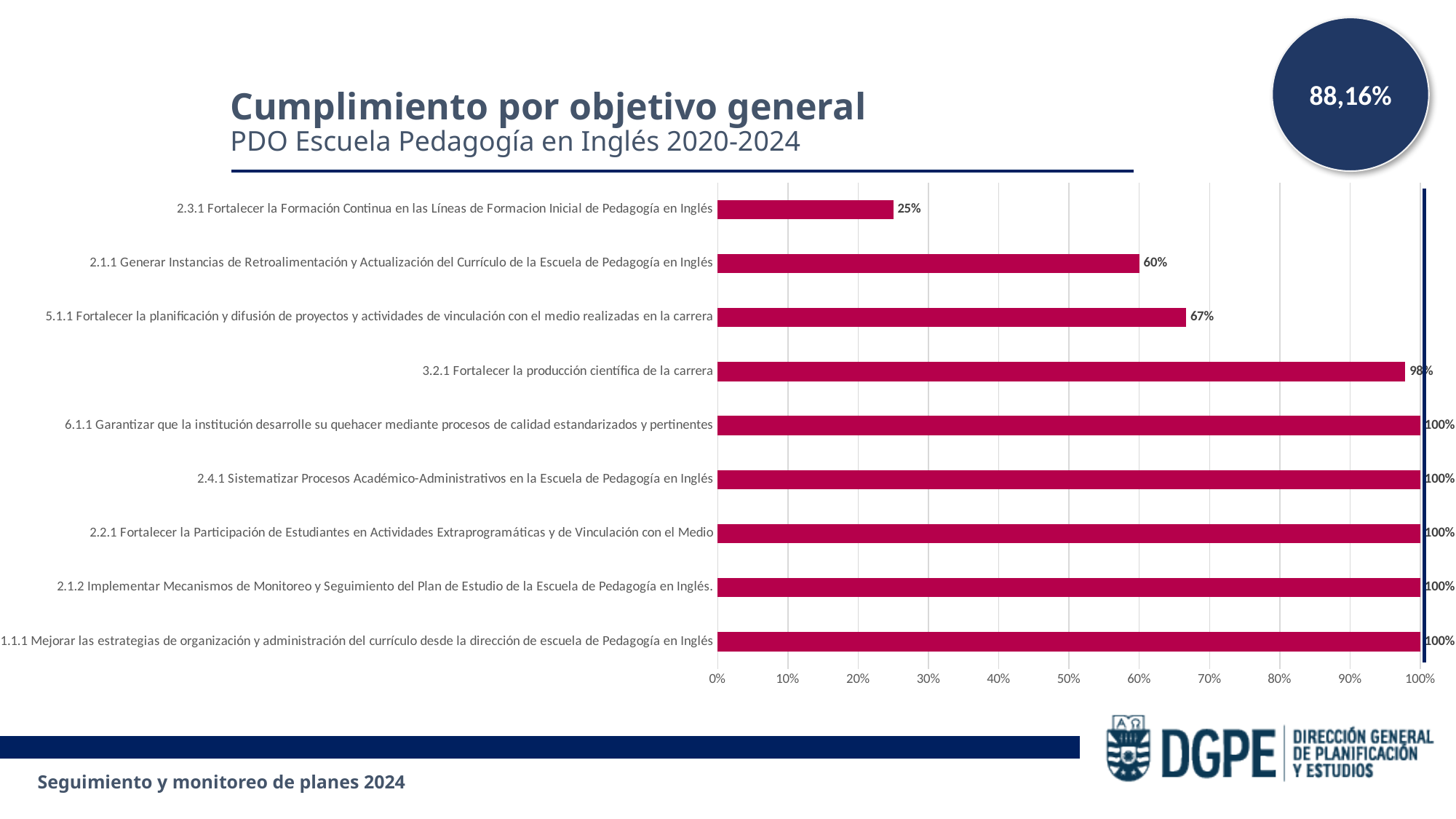
Which is larger, the value for objective 2.1.1 or the value for objective 5.1.1? 5.1.1 How many objectives have a value of 100%? 5 How many objectives are plotted in the chart? 9 What is the value for objective 3.2.1 Fortalecer la producción científica de la carrera? 98% What is the value for objective 2.3.1 Fortalecer la Formación Continua en las Líneas de Formacion Inicial de Pedagogía en Inglés? 25% What is the difference between the values for objective 3.2.1 and objective 2.3.1? 73% What is the value for objective 5.1.1 Fortalecer la planificación y difusión de proyectos y actividades de vinculación con el medio realizadas en la carrera? 67% What kind of chart is shown on the slide? Bar chart Is the value for objective 2.3.1 greater or less than 30%? less What is the value for objective 2.1.1 Generar Instancias de Retroalimentación y Actualización del Currículo de la Escuela de Pedagogía en Inglés? 60% Which objective has the lowest value in the chart? 2.3.1 Fortalecer la Formación Continua en las Líneas de Formacion Inicial de Pedagogía en Inglés What is the difference between the values for objective 5.1.1 and objective 2.1.1? 7%